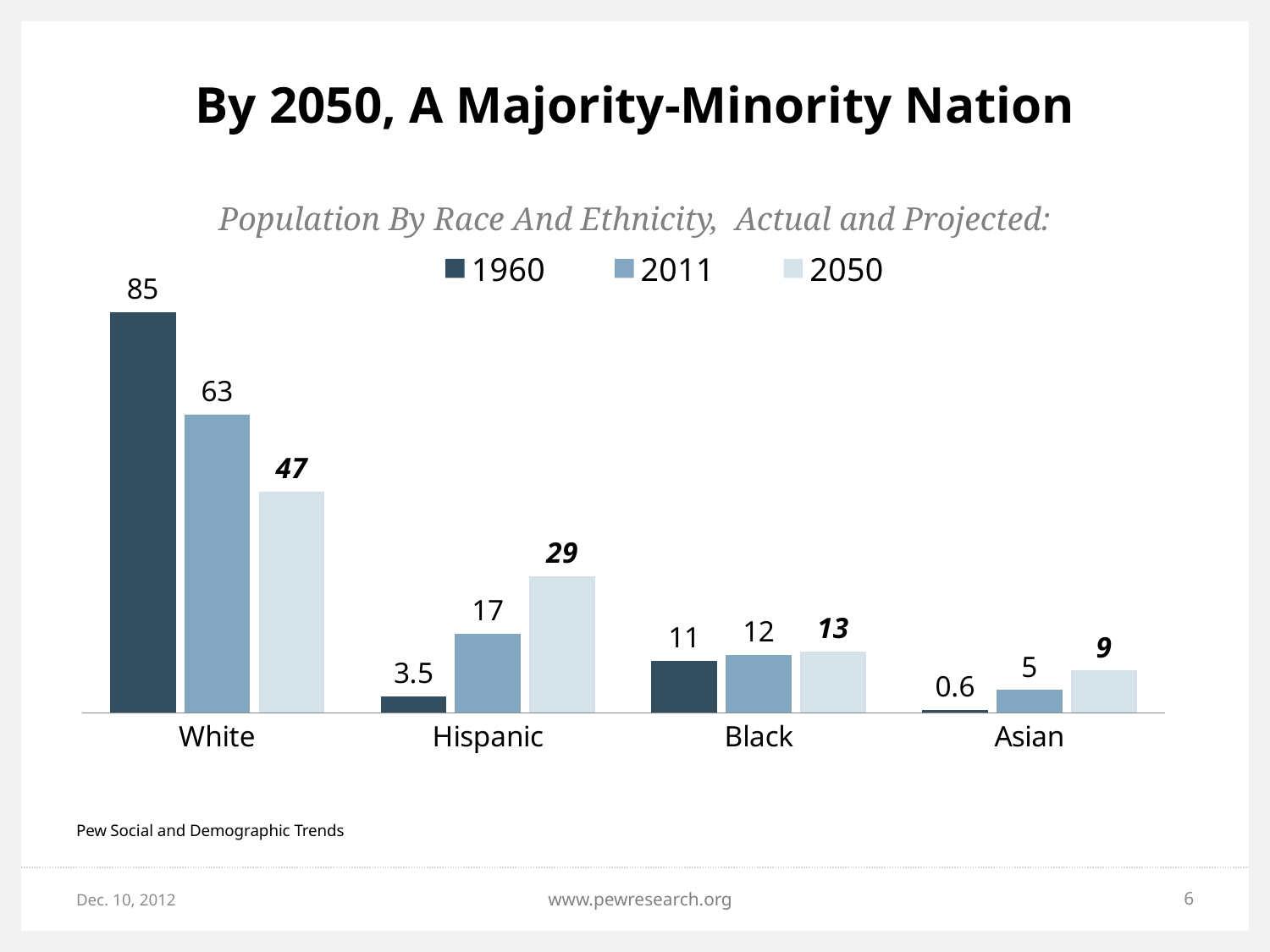
What kind of chart is shown on the slide? Bar chart Which category has the highest value in 2050? White What is the value for White in 1960? 85 What is the value for Black in 2011? 12 How many series does the legend list? 3 Do the values for Hispanic rise or fall from 1960 to 2050? Rise What is the projected value for Hispanic in 2050? 29 Which category has the lowest value in 1960? Asian What is the difference between the White values for 1960 and 2050? 38 What is the value for Asian in 1960? 0.6 Which is larger, the 2050 value for Hispanic or the 2050 value for Black? Hispanic How many race/ethnicity categories are shown on the x axis? 4